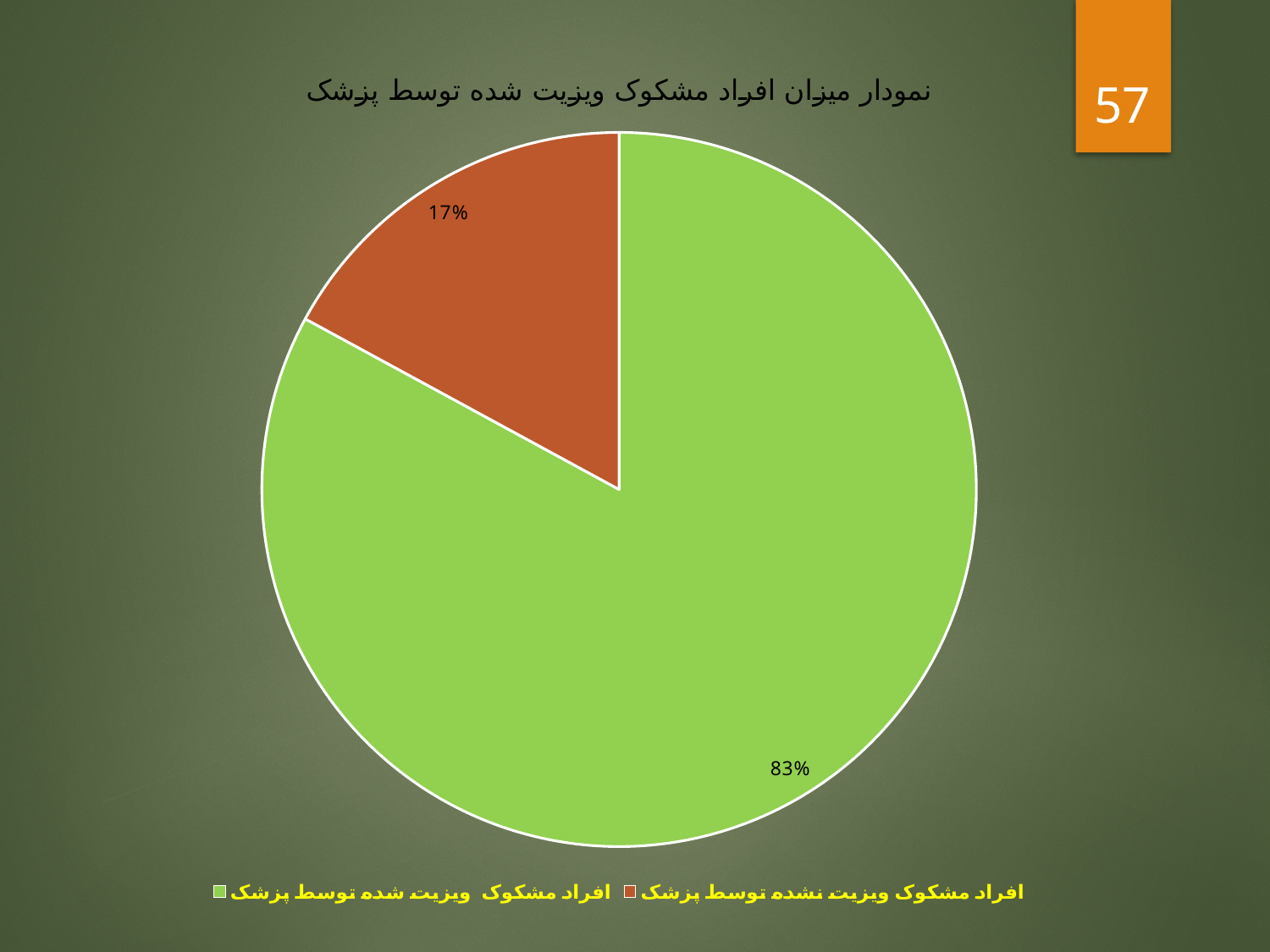
What kind of chart is shown on the slide? pie chart How many entries does the legend of the pie chart list? 2 What number is shown in the orange box at the top right of the slide? 57 What percentage is shown on the orange slice of the pie chart? 17% What percentage is shown on the green slice of the pie chart? 83% What share of the pie does the orange slice represent? 17% How many slices does the pie chart have? 2 What is the difference in percentage points between the green slice and the orange slice? 66 Which is larger, the green slice or the orange slice? the green slice Which slice of the pie chart is the smallest? the orange slice (17%) Which slice of the pie chart is the largest? the green slice (83%) What is the title of the pie chart? نمودار میزان افراد مشکوک ویزیت شده توسط پزشک